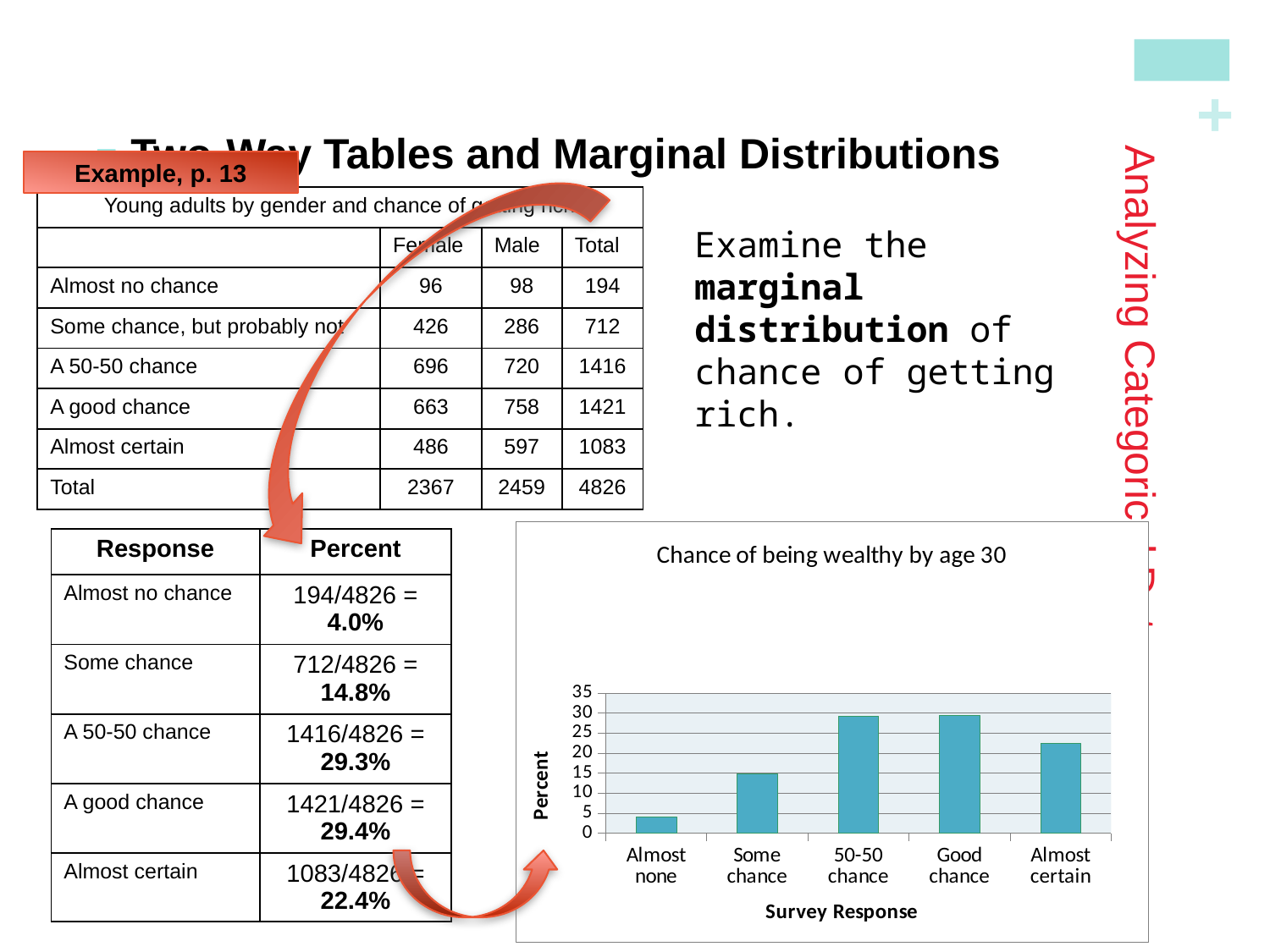
Which is larger on the chart, the value for Almost none or the value for Some chance? Some chance What is the label on the chart's y axis? Percent Is the value for Almost certain greater or less than 25? less What is the title of the chart? Chance of being wealthy by age 30 Which is larger on the chart, the value for Some chance or the value for Almost certain? Almost certain Is the value for Almost none greater or less than 5? less What kind of chart is shown on the slide? bar chart Is the value for 50-50 chance greater or less than 25? greater Which survey response has the lowest bar on the chart? Almost none How many survey response categories are shown on the chart's x axis? 5 Do the bar values rise or fall from Almost none to 50-50 chance along the x axis? rise